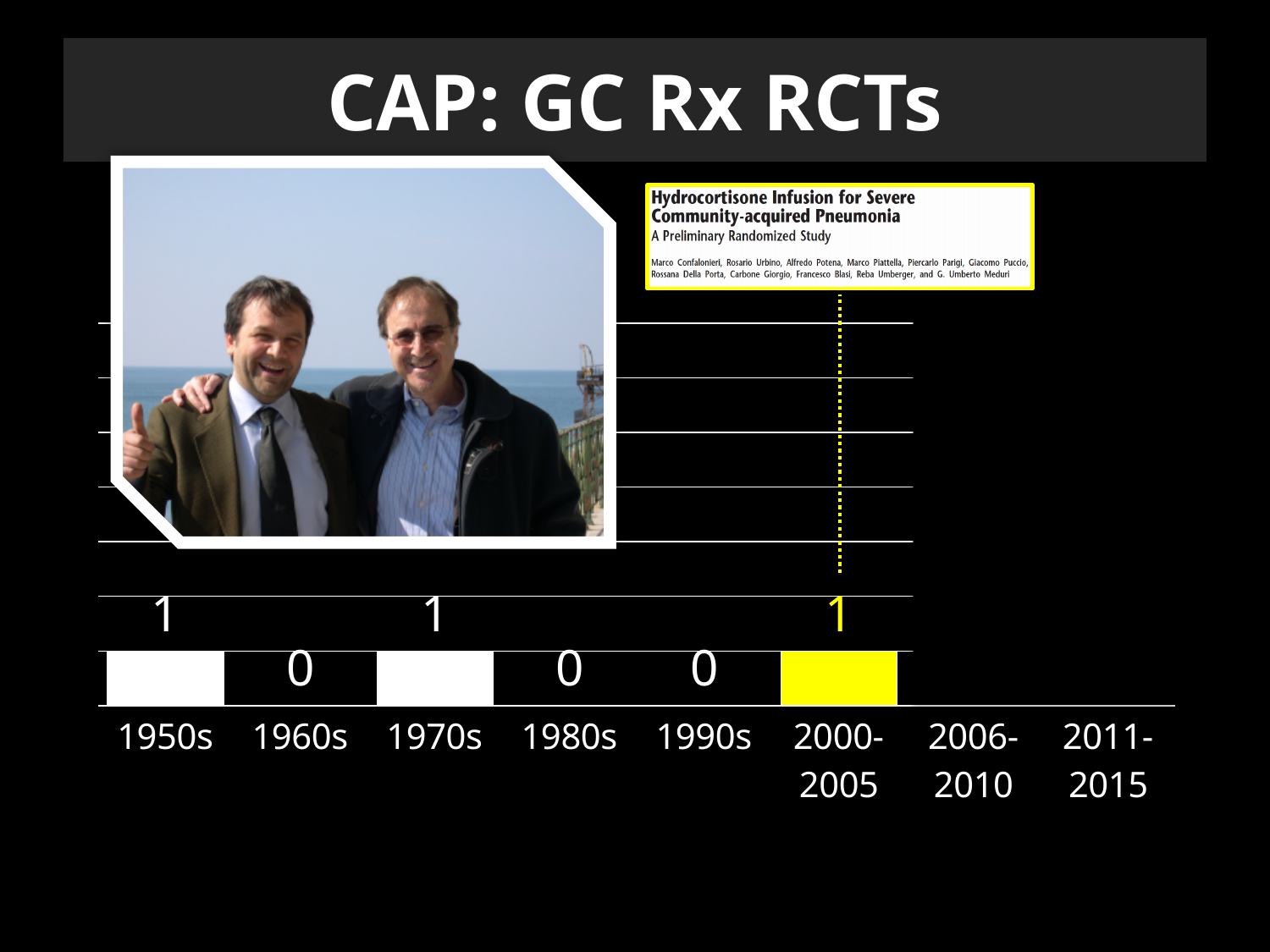
What is the difference between the values for the 1970s and the 1980s? 1 Which is larger, the value for the 1950s or the value for the 1960s? 1950s How many categories are labelled on the x axis? 8 What is the value for the 1950s? 1 What is the value for the 1980s? 0 What is the value for the 1970s? 1 What kind of chart is shown on the slide? bar chart What is the title of the slide containing the chart? CAP: GC Rx RCTs What is the value for 2000-2005? 1 What is the value for the 1990s? 0 What is the value for the 1960s? 0 What colour is the bar for 2000-2005? yellow